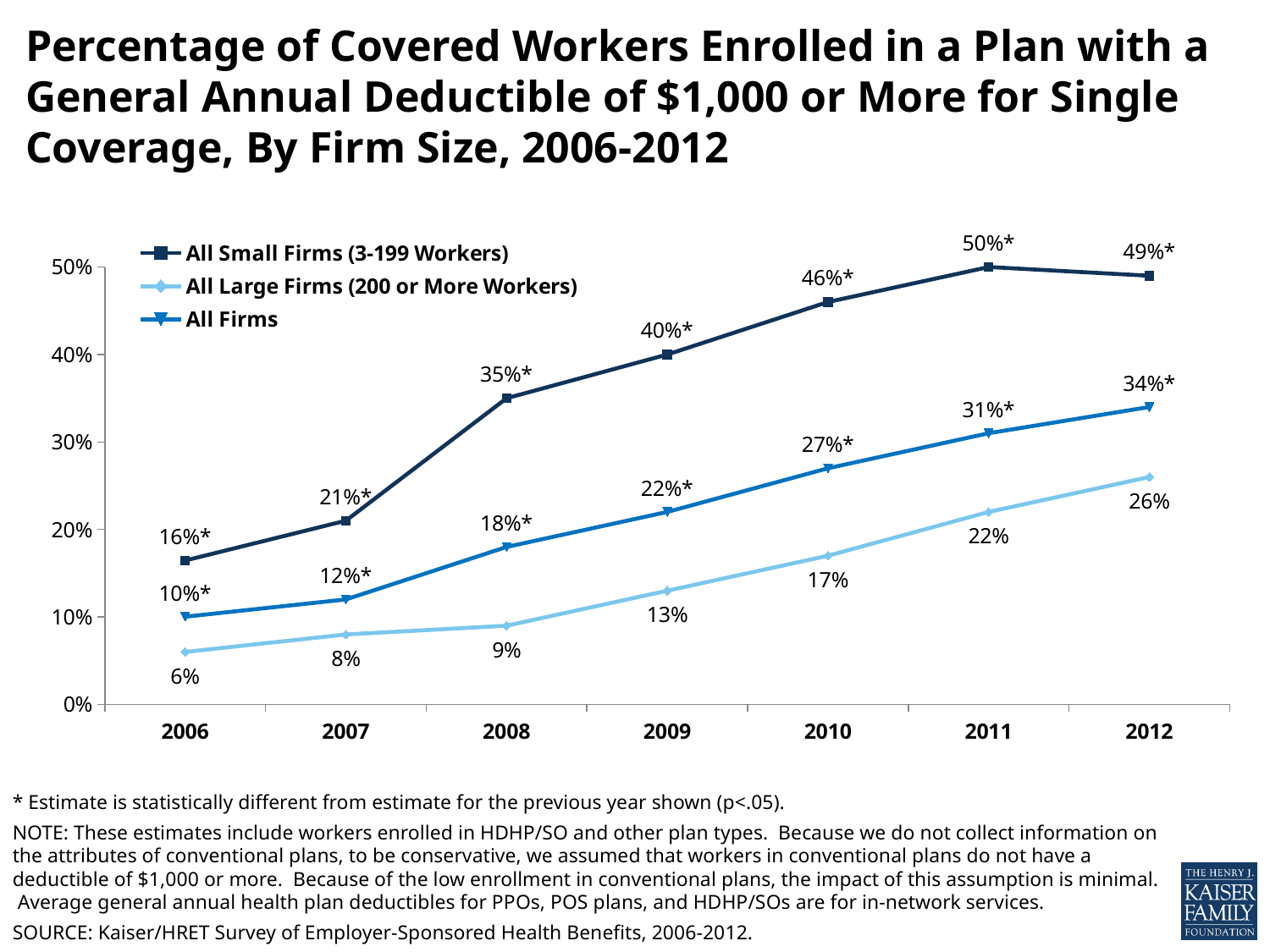
Which series has the larger value in 2009: All Firms or All Large Firms (200 or More Workers)? All Firms In which year does the All Small Firms (3-199 Workers) series reach its highest value? 2011 What kind of chart is shown on the slide? Line chart What is the value for All Large Firms (200 or More Workers) in 2006? 6% Does the All Large Firms (200 or More Workers) series rise or fall from 2006 to 2012? Rise Which series is drawn in the darkest line colour? All Small Firms (3-199 Workers) In which year is the All Large Firms (200 or More Workers) value lowest? 2006 How many series does the legend list? 3 How many years are plotted on the x axis? 7 What is the difference between the All Small Firms value and the All Large Firms value in 2012? 23 percentage points What percentage of covered workers at All Small Firms (3-199 Workers) were enrolled in a plan with a deductible of $1,000 or more in 2011? 50% What is the value for All Firms in 2012? 34%